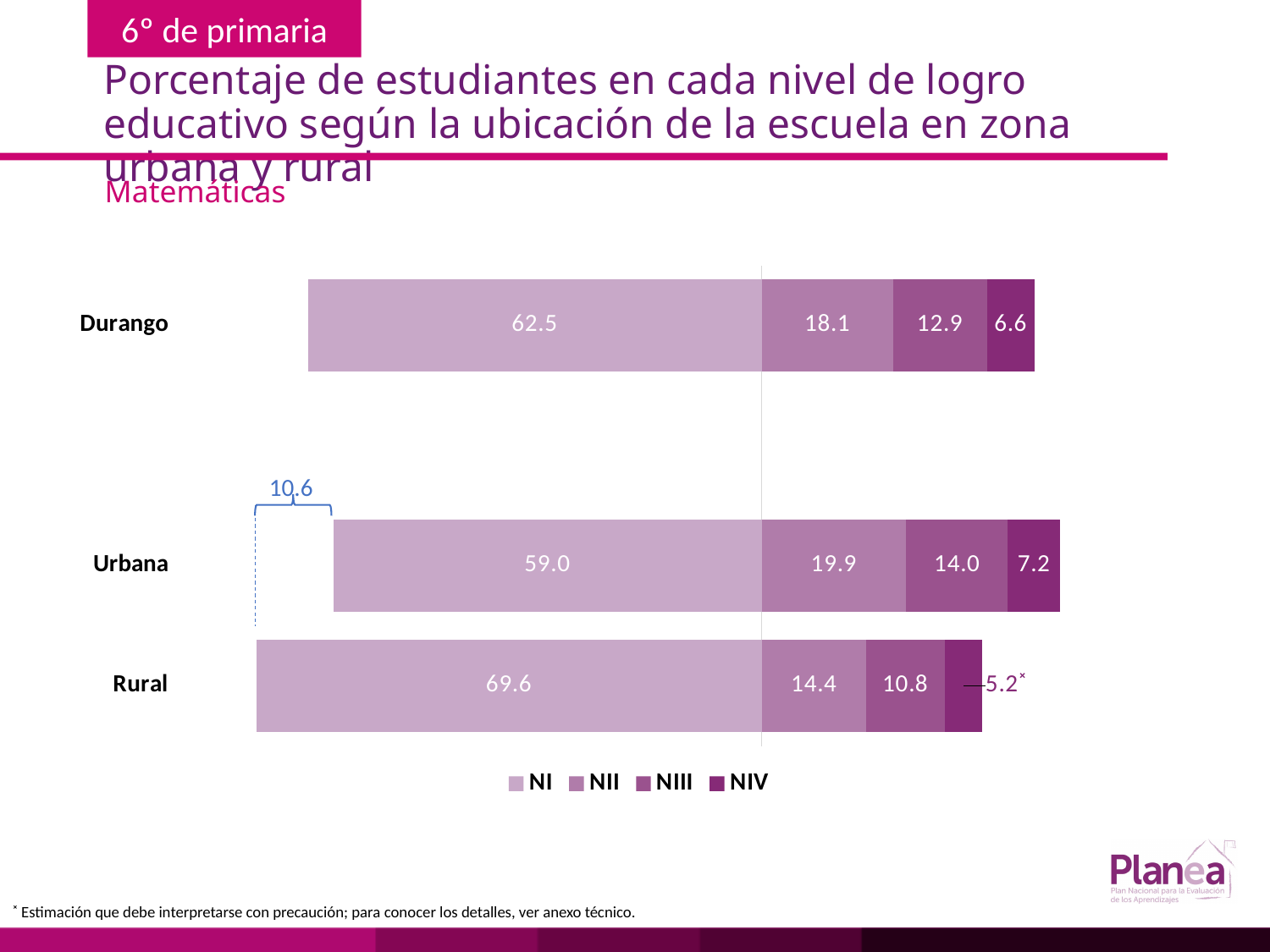
What percentage of Rural students are at level NI? 69.6 Which category has the lowest NIV value? Rural Which category has the highest NI value? Rural What is the NII value for Urbana? 19.9 Which subject is the chart about, according to the subtitle? Matemáticas How many series does the legend list? 4 What is the difference between the NI values for Rural and Urbana? 10.6 Which is larger, the NII value for Durango or the NII value for Rural? Durango How many categories are shown on the chart? 3 What kind of chart is shown on the slide? Stacked bar chart What is the NIII value for Rural? 10.8 What is the NIV value for Durango? 6.6